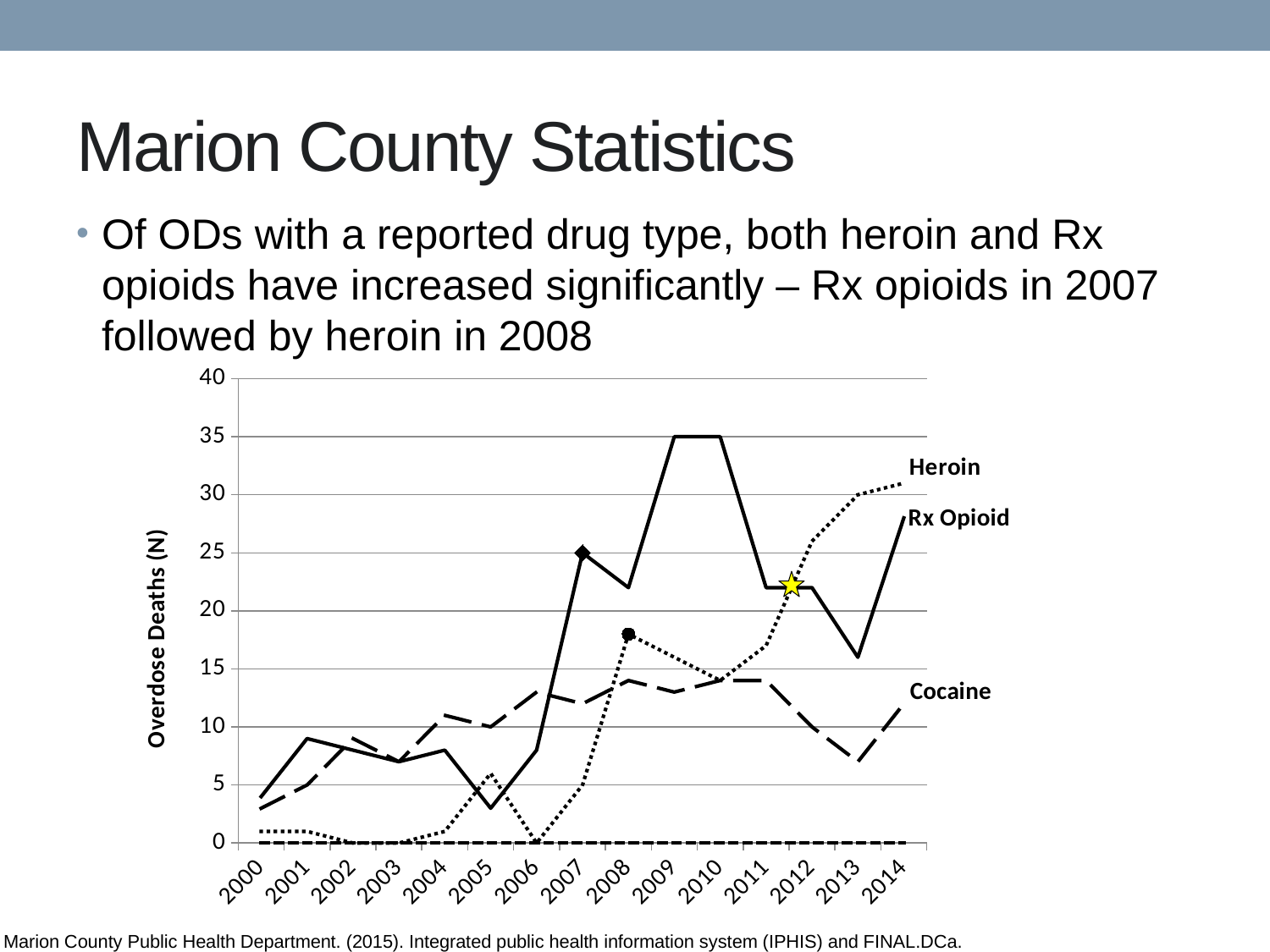
Does the Heroin line rise or fall from 2008 to 2014? rise What is the Rx Opioid value in 2007? 25 In 2009, which is larger, the Rx Opioid value or the Heroin value? Rx Opioid What kind of chart is shown on the slide? line chart What is the title of the y axis of the chart? Overdose Deaths (N) What is the Rx Opioid value in 2010? 35 Which series has the highest value in 2014? Heroin Is the Cocaine value in 2013 greater or less than 10? less How many years are shown along the x axis of the chart? 15 Is the Heroin value in 2014 greater or less than 25? greater Is the Rx Opioid value in 2013 greater or less than 20? less